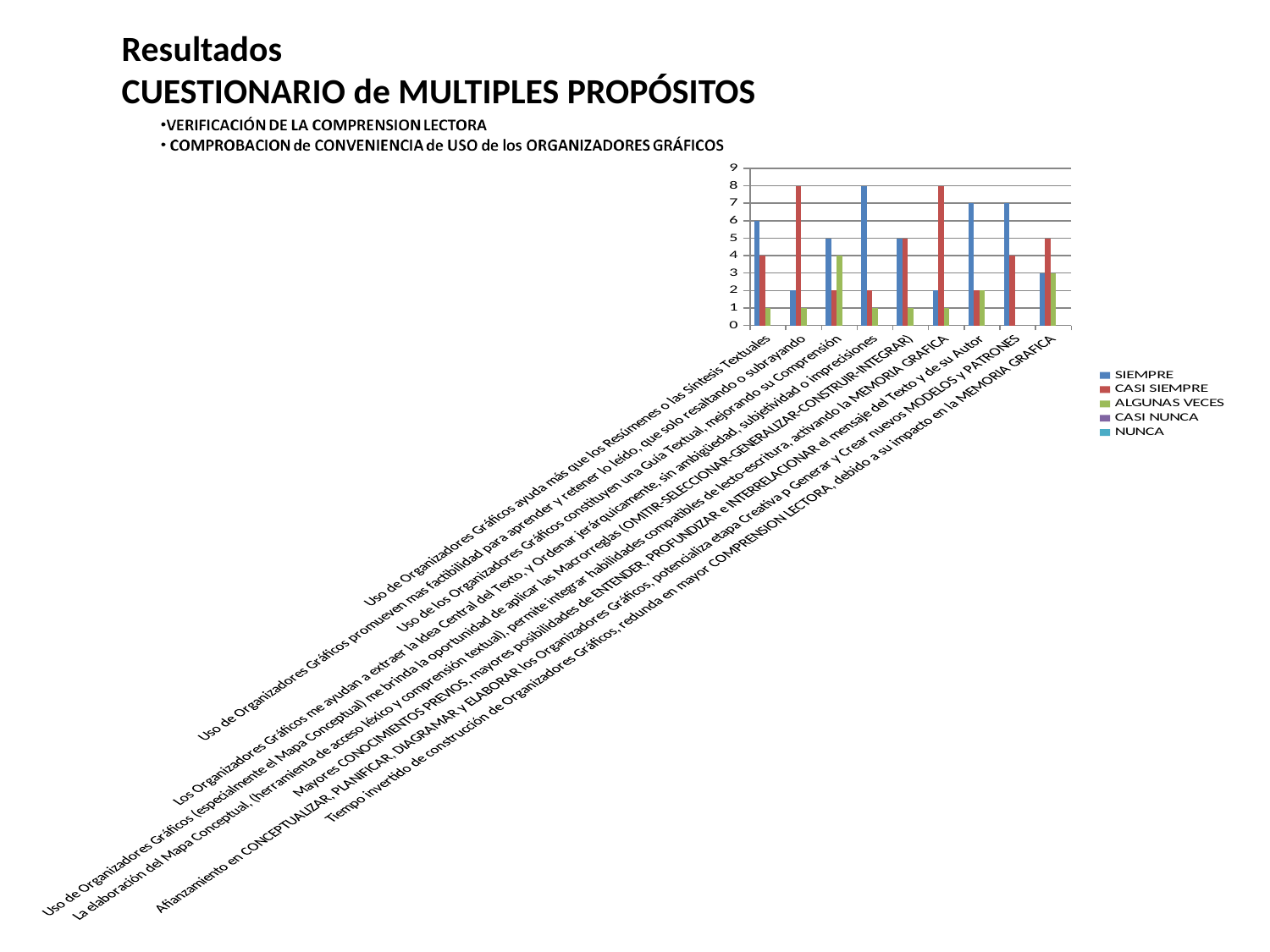
Is the SIEMPRE value for 'Afianzamiento en CONCEPTUALIZAR, PLANIFICAR, DIAGRAMAR y ELABORAR los Organizadores Gráficos, potencializa etapa Creativa p Generar y Crear nuevos MODELOS y PATRONES' greater or less than 5? greater What is the CASI SIEMPRE value for the category 'Mayores CONOCIMIENTOS PREVIOS, mayores posibilidades de ENTENDER, PROFUNDIZAR e INTERRELACIONAR el mensaje del Texto y de su Autor'? 2 Which category has the highest SIEMPRE value? Los Organizadores Gráficos me ayudan a extraer la Idea Central del Texto, y Ordenar jerárquicamente, sin ambigüedad, subjetividad o imprecisiones How many categories are plotted along the x axis? 9 How many series does the legend list? 5 Which series is shown in red in the legend? CASI SIEMPRE What is the difference between the CASI SIEMPRE value and the SIEMPRE value for the category 'Uso de Organizadores Gráficos promueven mas factibilidad para aprender y retener lo leído, que solo resaltando o subrayando'? 6 What is the ALGUNAS VECES value for the category 'Uso de los Organizadores Gráficos constituyen una Guía Textual, mejorando su Comprensión'? 4 What is the SIEMPRE value for the category 'Uso de Organizadores Gráficos ayuda más que los Resúmenes o las Síntesis Textuales'? 6 For the category 'Uso de Organizadores Gráficos ayuda más que los Resúmenes o las Síntesis Textuales', which is larger, SIEMPRE or CASI SIEMPRE? SIEMPRE What is the ALGUNAS VECES value for the category 'Tiempo invertido de construcción de Organizadores Gráficos, redunda en mayor COMPRENSION LECTORA, debido a su impacto en la MEMORIA GRAFICA'? 3 What kind of chart is shown on the slide? bar chart